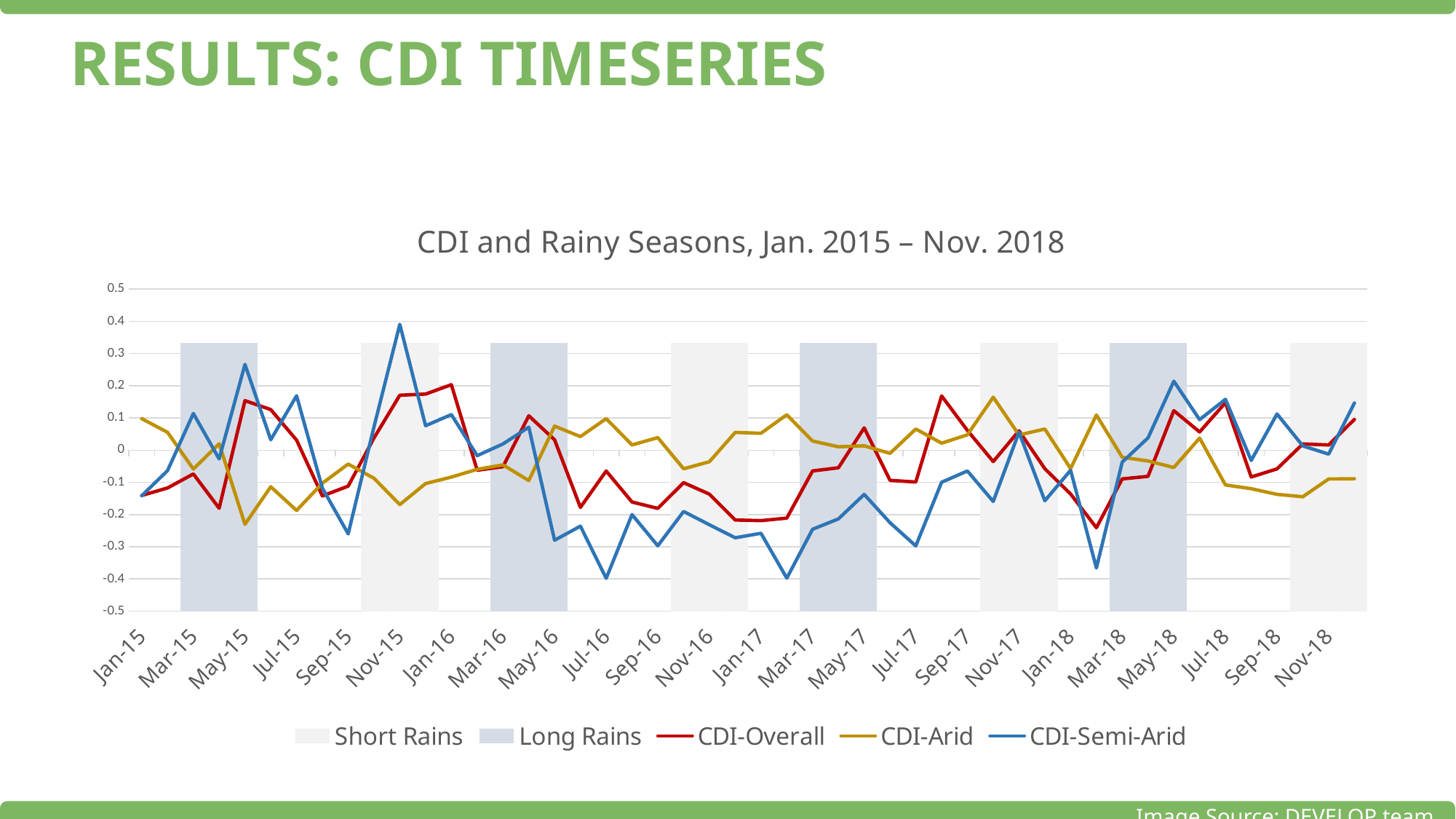
Is the value for CDI-Semi-Arid at Nov-15 greater or less than 0.3? greater What kind of chart is shown on the slide? line chart How many entries does the chart legend list? 5 Which series reaches the highest value anywhere on the chart? CDI-Semi-Arid How many CDI line series are plotted on the chart? 3 Is the value for CDI-Arid at Oct-17 greater or less than 0.1? greater Is the value for CDI-Arid at May-15 greater or less than -0.2? less What is the title of the chart? CDI and Rainy Seasons, Jan. 2015 – Nov. 2018 Which series reaches the lowest value anywhere on the chart? CDI-Semi-Arid At Jul-16, which is larger: CDI-Arid or CDI-Semi-Arid? CDI-Arid How many Long Rains shaded bands appear on the chart? 4